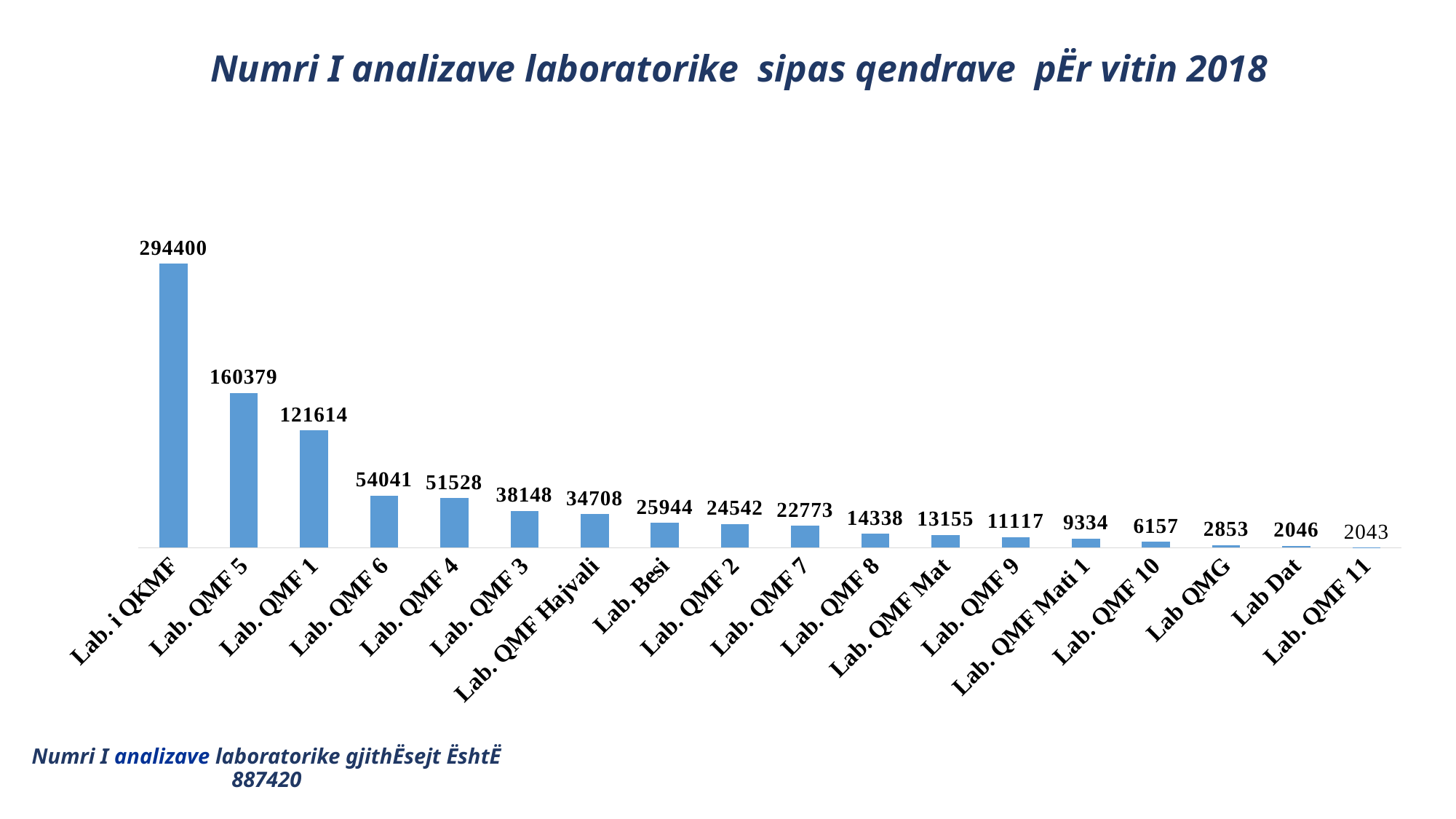
What is the difference between the values for Lab. i QKMF and Lab. QMF 5? 134021 What is the value for Lab. QMF Hajvali? 34708 What is the difference between the values for Lab. QMF 5 and Lab. QMF 1? 38765 How many categories are shown in the chart? 18 What kind of chart is shown on the slide? Bar chart Do the values rise or fall from left to right along the x axis? Fall What is the value for Lab. QMF Mati 1? 9334 Which category has the highest value? Lab. i QKMF What is the value for Lab. QMF 5? 160379 What is the value for Lab QMG? 2853 Which is larger, the value for Lab. QMF 6 or the value for Lab. QMF 3? Lab. QMF 6 Which is larger, the value for Lab. Besi or the value for Lab. QMF 8? Lab. Besi